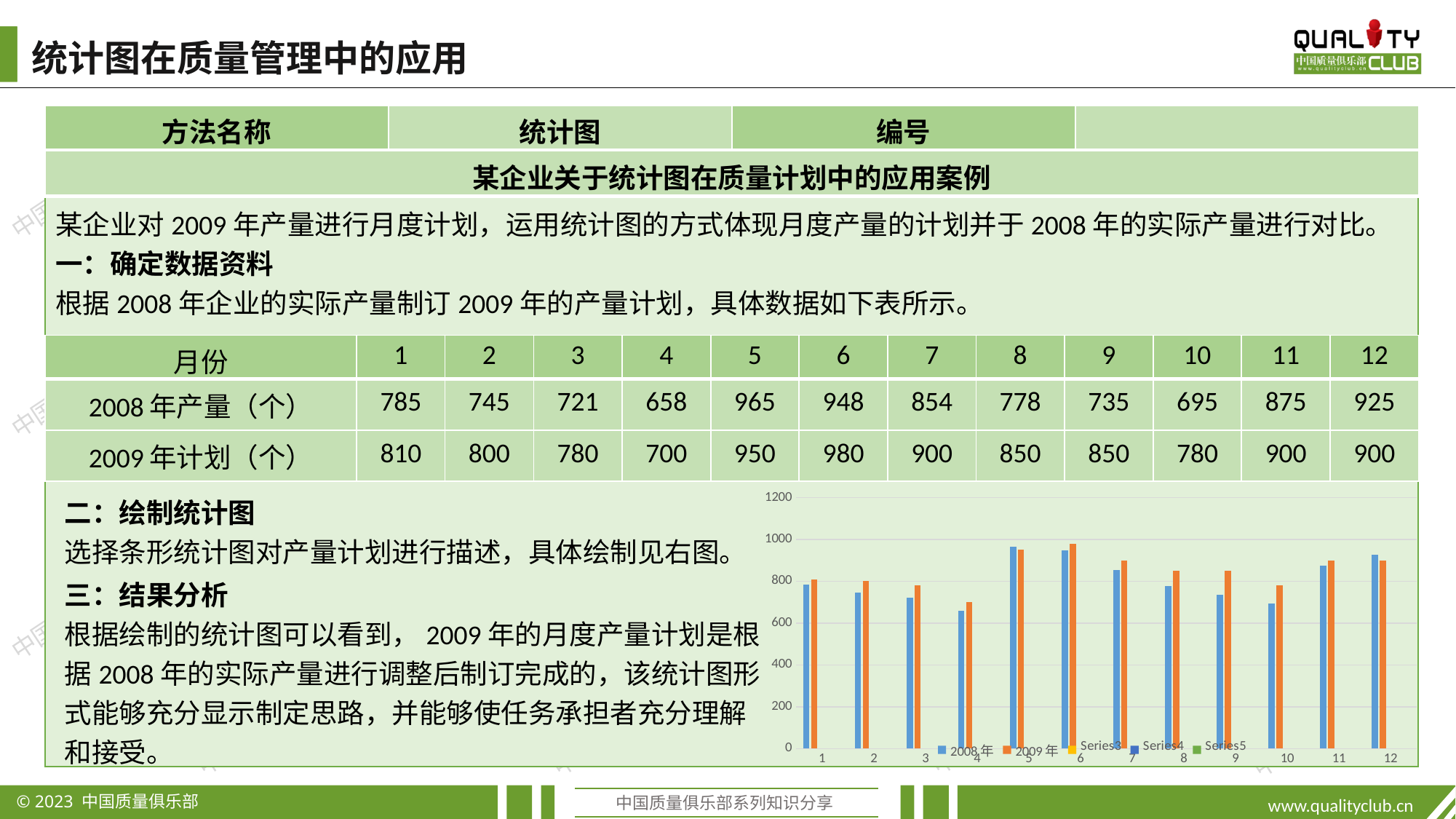
How many months (categories) are plotted along the x axis of the chart? 12 How many entries does the chart's legend list? 5 What is the 2008年产量 value for month 5? 965 What is the 2009年计划 value for month 6? 980 What is the difference between the 2009年计划 and 2008年产量 values for month 10? 85 What kind of chart is shown on the right of the slide? bar chart Which month has the lowest 2009年计划? 4 Is the 2008年 value for month 4 greater or less than 800? less Which month has the lowest 2008年产量? 4 Which month has the highest 2008年产量? 5 For month 10, which is larger, the 2008年 value or the 2009年 value? 2009年 What are the first two legend entries of the chart? 2008年, 2009年